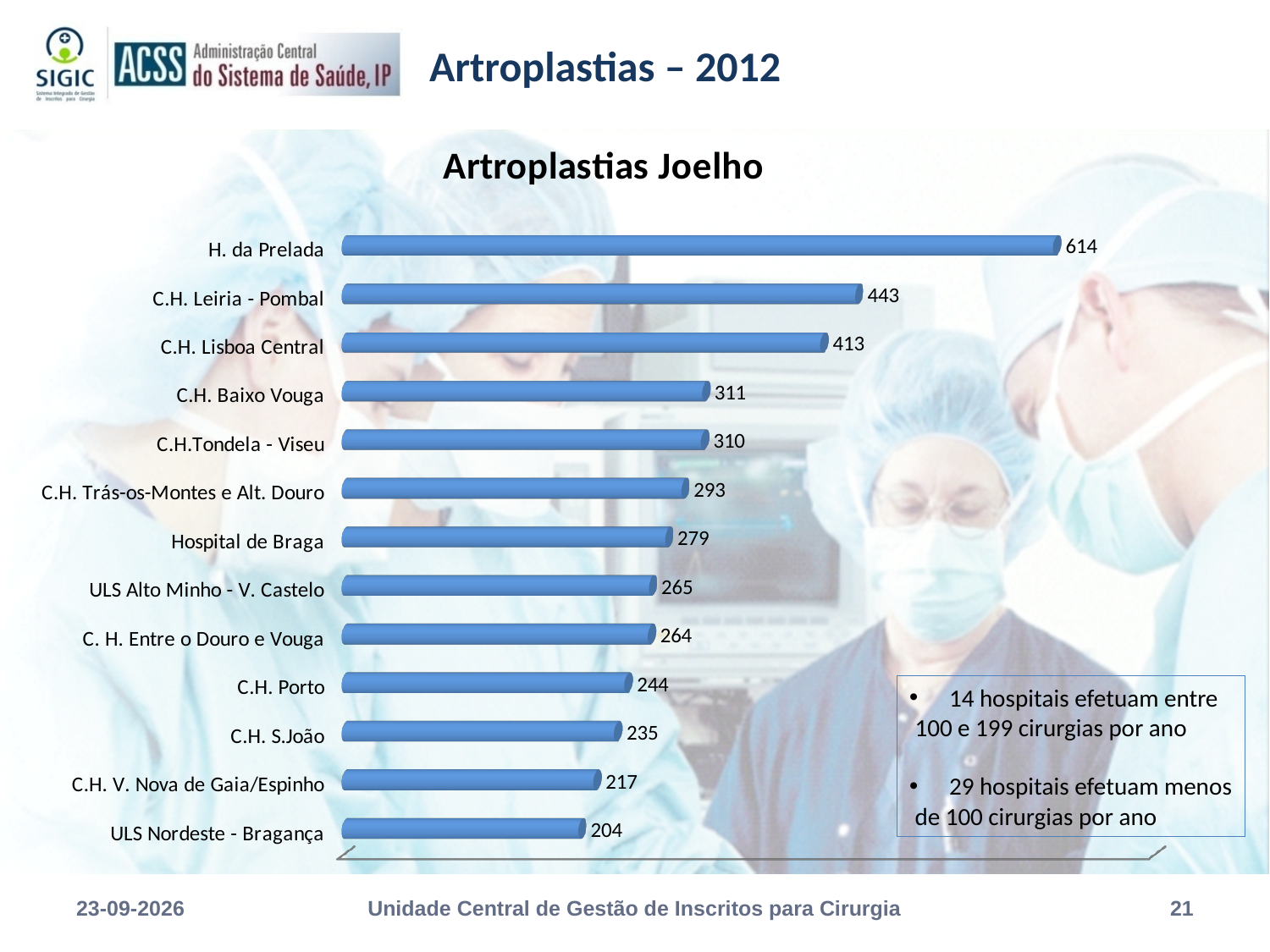
Which hospital has the highest value? H. da Prelada What is the difference between the values for H. da Prelada and C.H. Leiria - Pombal? 171 What kind of chart is shown? Bar chart How many hospitals are shown in the chart? 13 What is the value for C.H. Lisboa Central? 413 Which hospital has the lowest value? ULS Nordeste - Bragança What is the value for H. da Prelada? 614 What is the difference between the values for C.H. Porto and C.H. S.João? 9 What is the value for Hospital de Braga? 279 What is the title of the chart? Artroplastias Joelho What is the value for ULS Nordeste - Bragança? 204 Which has a larger value, C.H. Baixo Vouga or C.H. Trás-os-Montes e Alt. Douro? C.H. Baixo Vouga